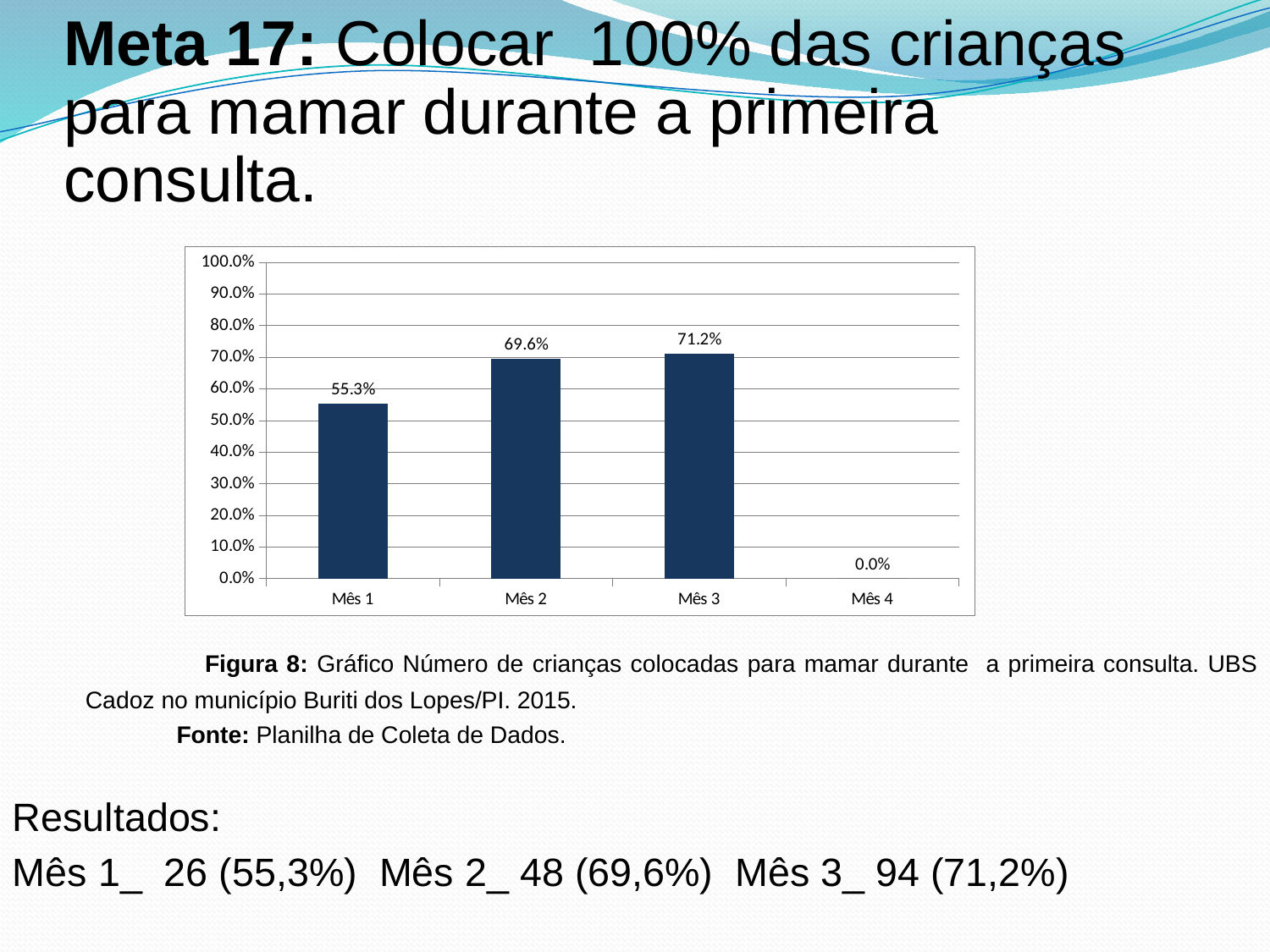
What is the value for Mês 4? 0.0% What is the value for Mês 3? 71.2% Which month has the highest value? Mês 3 Which is larger, the value for Mês 1 or the value for Mês 2? Mês 2 Do the values rise or fall from Mês 1 to Mês 3? Rise Which month has the lowest value? Mês 4 What is the value for Mês 2? 69.6% How many months are shown on the x axis? 4 What is the value for Mês 1? 55.3% What is the difference between the values for Mês 2 and Mês 1? 14.3% What is the difference between the values for Mês 3 and Mês 1? 15.9% What kind of chart is shown on the slide? Bar chart